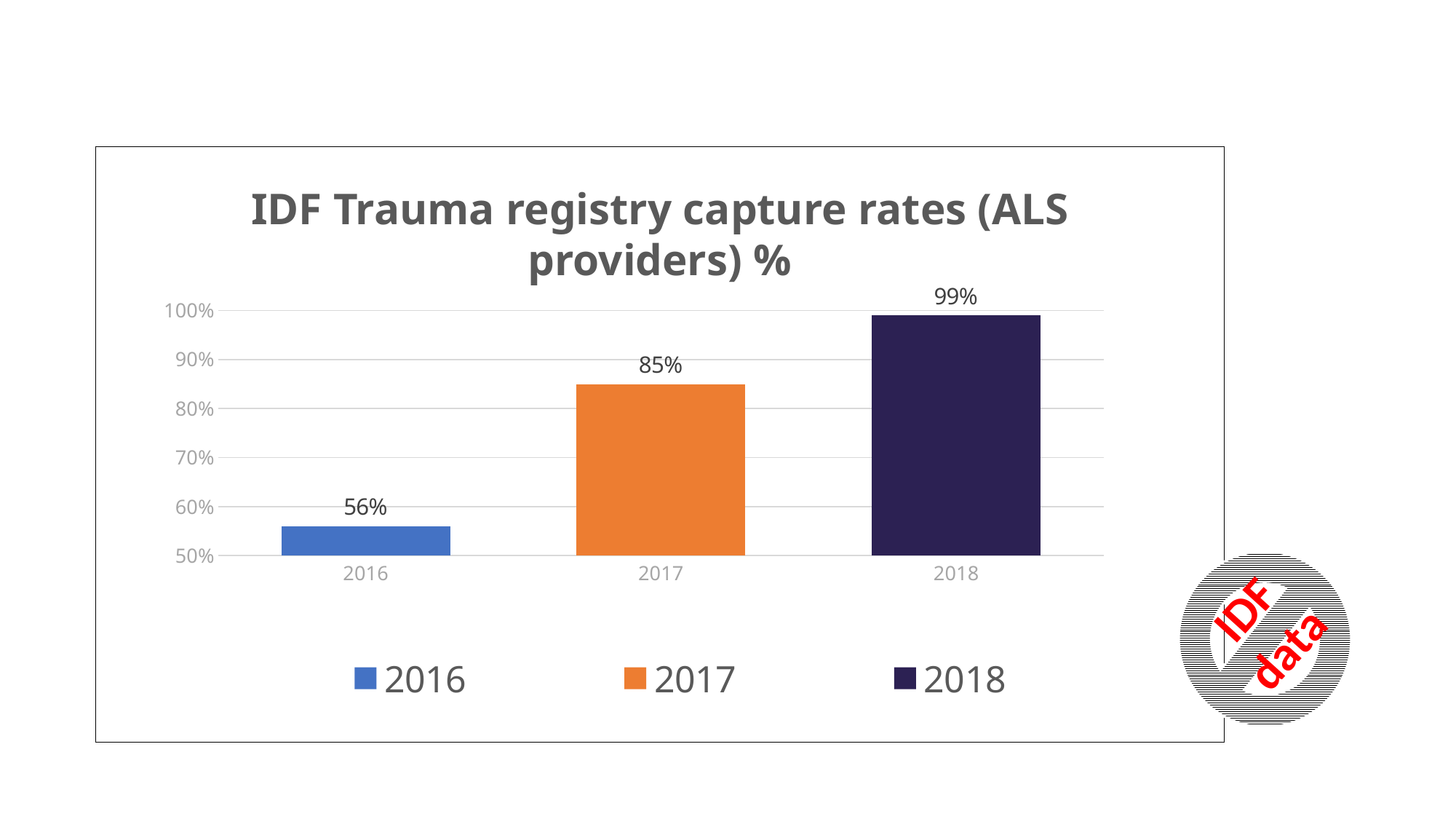
Which year has the highest capture rate? 2018 How many years are shown on the chart? 3 What kind of chart is shown on the slide? bar chart What is the difference between the capture rates for 2018 and 2016? 43% What is the capture rate for 2017? 85% What is the difference between the capture rates for 2017 and 2016? 29% Which year has the lowest capture rate? 2016 Is the value for 2017 greater or less than 80%? greater Do the capture rates rise or fall from 2016 to 2018? rise What is the capture rate for 2016? 56% What is the capture rate for 2018? 99% Which is larger, the capture rate for 2017 or for 2016? 2017